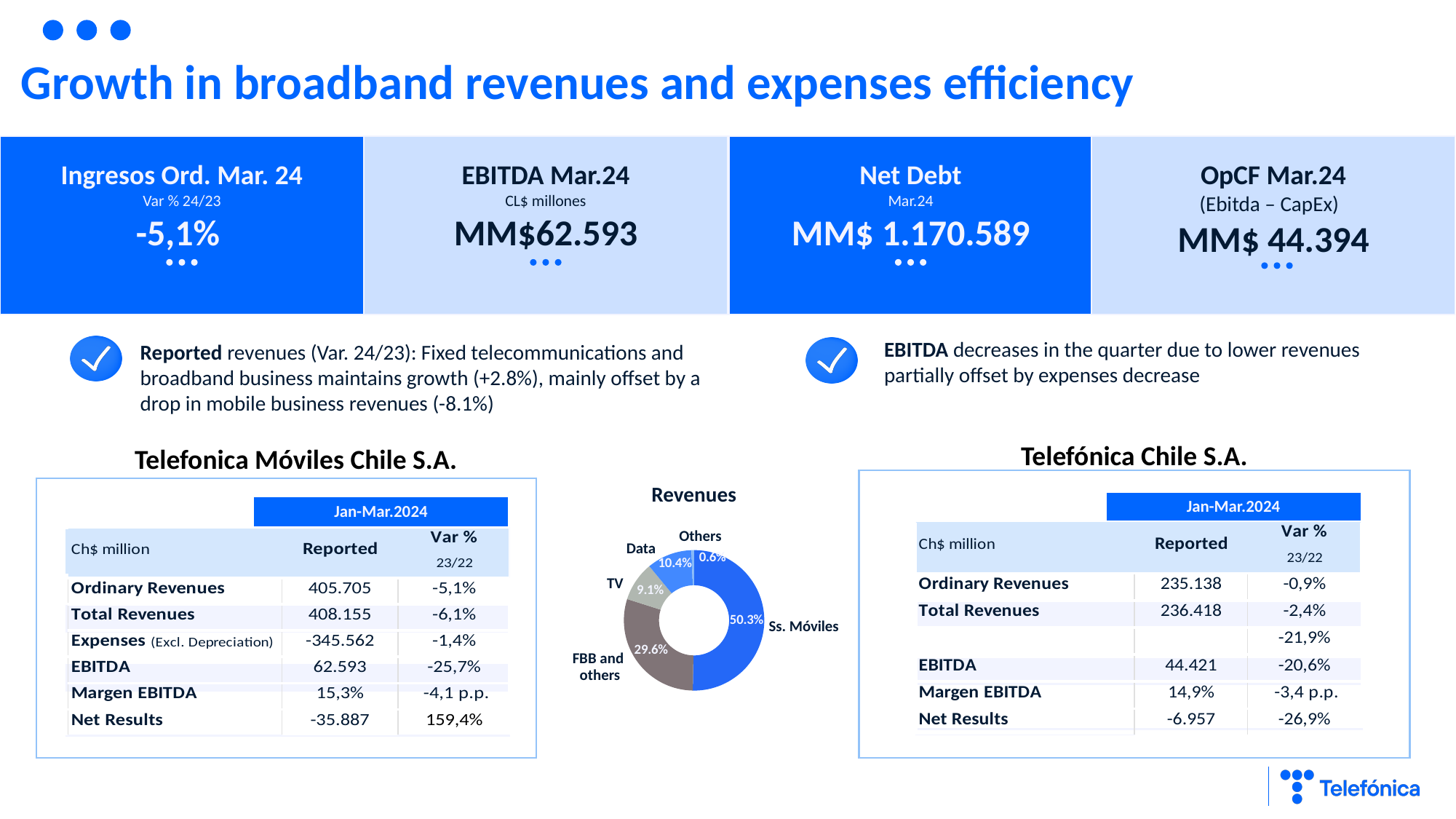
In the Revenues chart, which slice is larger: Data or TV? Data What type of chart is the Revenues chart? Pie (donut) chart What share of the Revenues chart does Ss. Móviles account for? 50.3% Which category has the largest slice in the Revenues chart? Ss. Móviles What share of the Revenues chart does Others account for? 0.6% What share of the Revenues chart does TV account for? 9.1% What share of the Revenues chart does FBB and others account for? 29.6% How many slices are shown in the Revenues chart? 5 In the Revenues chart, what is the difference in percentage points between the Ss. Móviles and FBB and others slices? 20.7 Which category has the smallest slice in the Revenues chart? Others What share of the Revenues chart does Data account for? 10.4% What is the title of the pie chart on the slide? Revenues